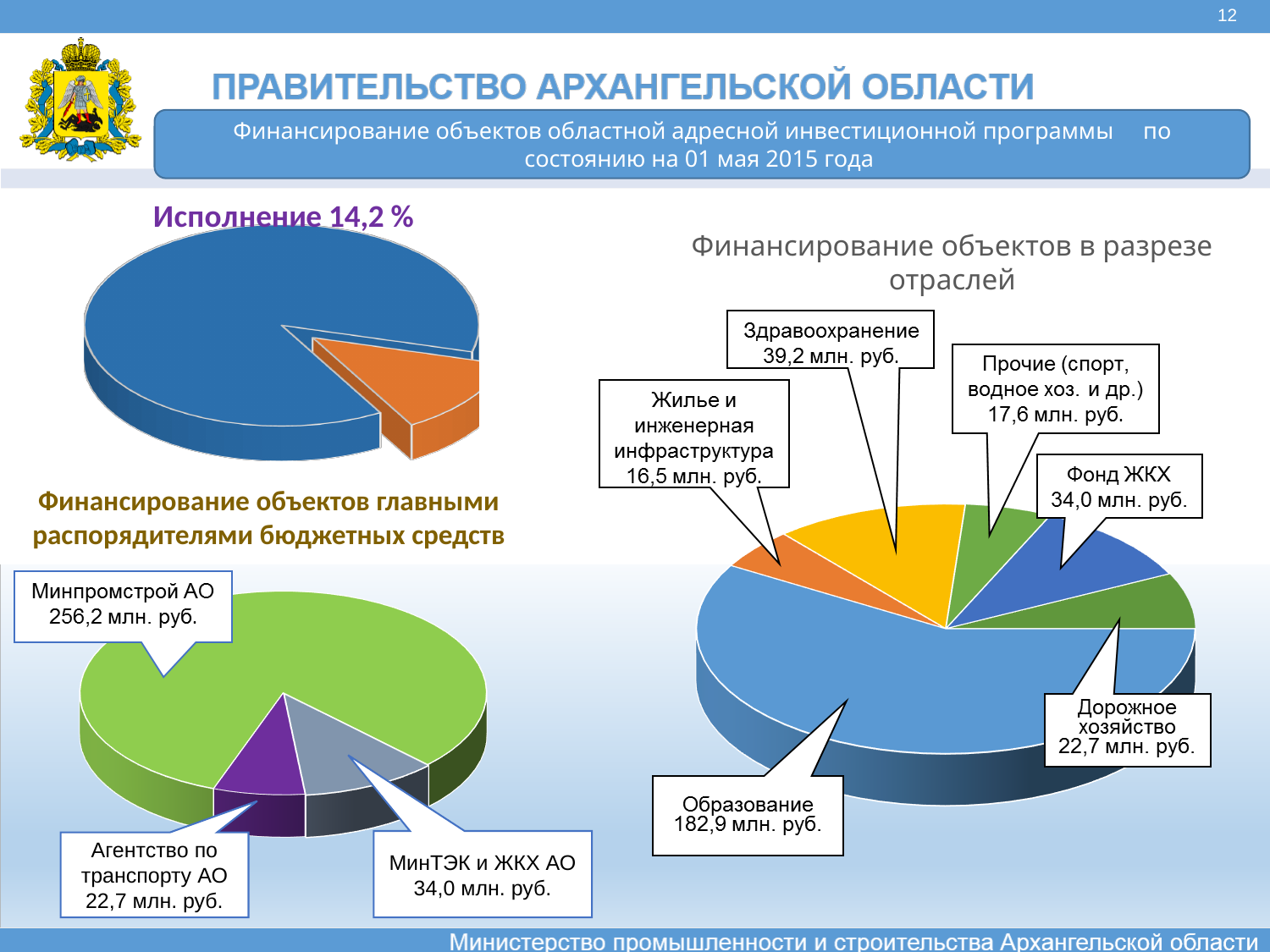
In the chart 'Финансирование объектов в разрезе отраслей', what is the value for Здравоохранение? 39,2 млн. руб. In the chart 'Финансирование объектов в разрезе отраслей', which is larger: Фонд ЖКХ or Дорожное хозяйство? Фонд ЖКХ In the chart 'Финансирование объектов главными распорядителями бюджетных средств', what is the value for Минпромстрой АО? 256,2 млн. руб. In the chart 'Финансирование объектов в разрезе отраслей', which category has the smallest value? Жилье и инженерная инфраструктура In the chart 'Финансирование объектов главными распорядителями бюджетных средств', which category has the largest value? Минпромстрой АО In the chart 'Финансирование объектов в разрезе отраслей', what is the value for Образование? 182,9 млн. руб. How many slices does the chart 'Финансирование объектов главными распорядителями бюджетных средств' have? 3 In the chart 'Финансирование объектов в разрезе отраслей', what is the difference between Образование and Здравоохранение? 143,7 млн. руб. What kind of chart is the chart titled 'Исполнение 14,2 %' in the top left of the slide? Pie chart In the chart 'Финансирование объектов главными распорядителями бюджетных средств', what is the value for Агентство по транспорту АО? 22,7 млн. руб. How many categories are shown in the chart 'Финансирование объектов в разрезе отраслей'? 6 In the chart 'Финансирование объектов главными распорядителями бюджетных средств', what is the difference between Минпромстрой АО and МинТЭК и ЖКХ АО? 222,2 млн. руб.